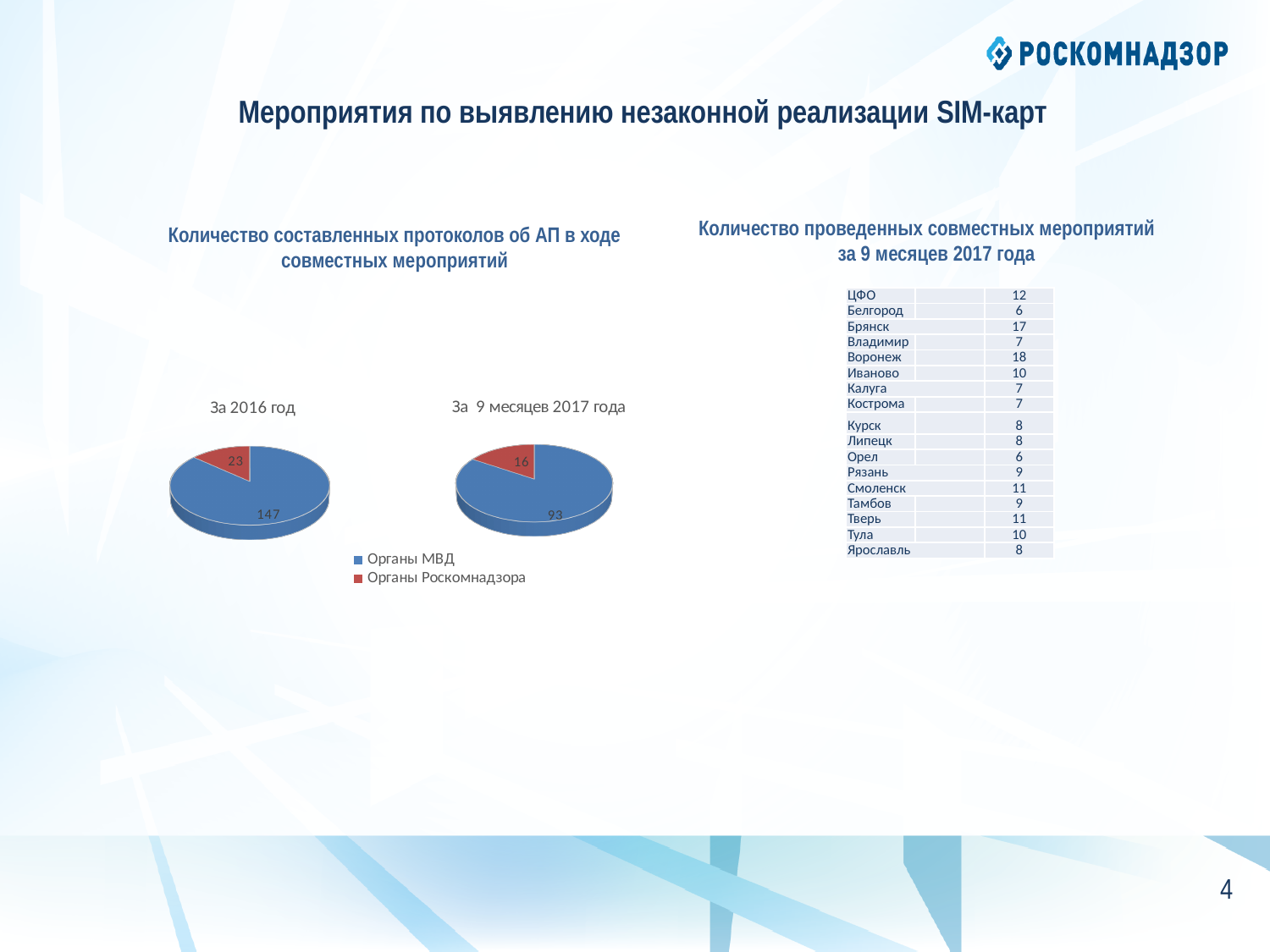
In the pie chart 'За 2016 год', what is the value for Органы МВД? 147 In the pie charts, which colour represents Органы Роскомнадзора? Red In the pie chart 'За 9 месяцев 2017 года', which category has the smallest slice? Органы Роскомнадзора In the pie chart 'За 2016 год', which category has the largest slice? Органы МВД In the pie chart 'За 9 месяцев 2017 года', what is the value for Органы МВД? 93 What is the total of the two slices in the pie chart 'За 9 месяцев 2017 года'? 109 How many entries does the legend shared by the two pie charts list? 2 In the pie chart 'За 9 месяцев 2017 года', what is the value for Органы Роскомнадзора? 16 In the pie chart 'За 2016 год', what is the difference between the values for Органы МВД and Органы Роскомнадзора? 124 In the pie chart 'За 2016 год', what is the value for Органы Роскомнадзора? 23 Is the value for Органы МВД larger in the pie chart 'За 2016 год' or in the pie chart 'За 9 месяцев 2017 года'? За 2016 год What kind of charts are shown under the heading 'Количество составленных протоколов об АП в ходе совместных мероприятий'? Pie charts